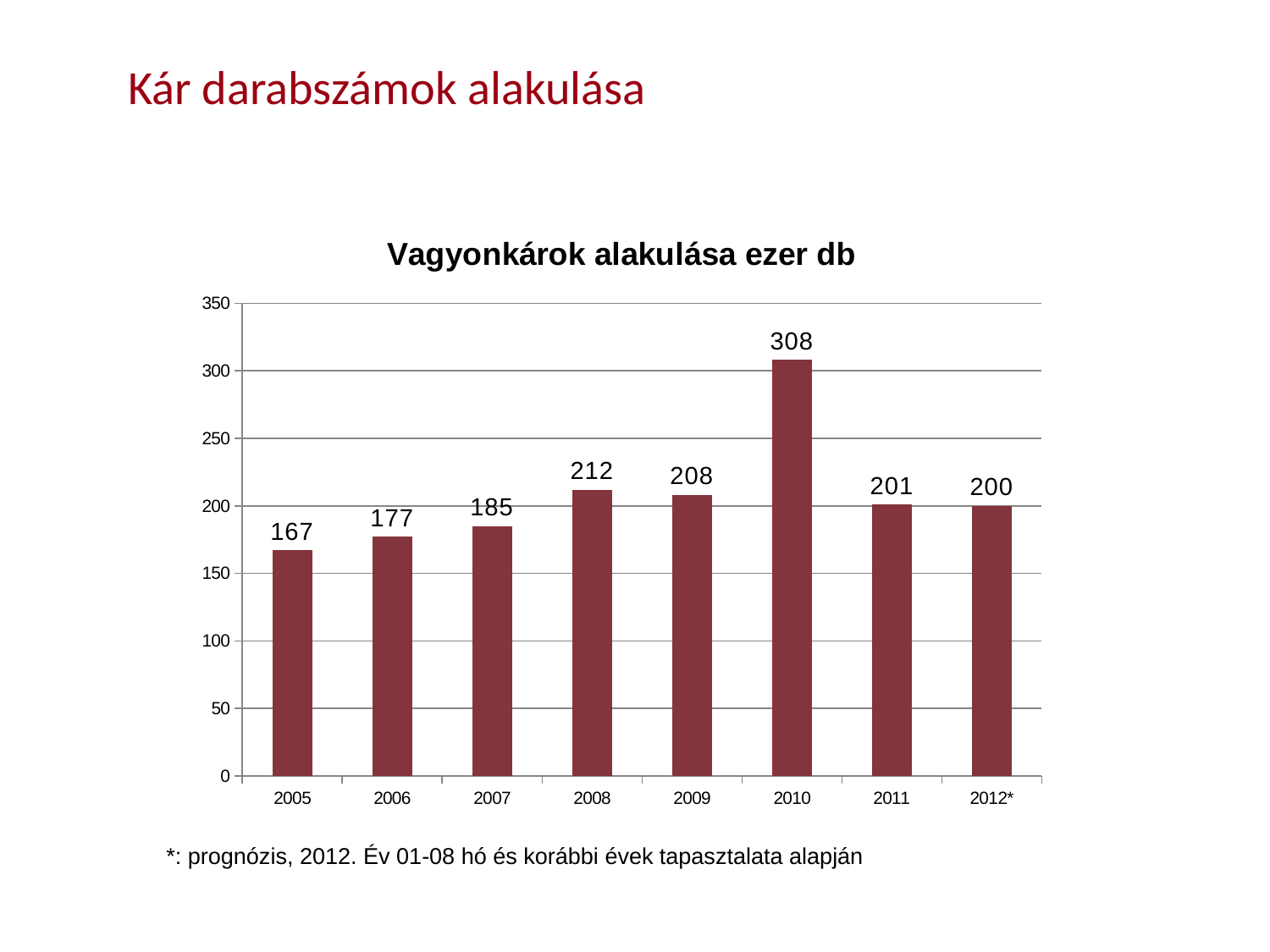
What is the value for 2005? 167 Which is larger, the value for 2008 or the value for 2011? 2008 Which year has the highest value? 2010 What is the difference between the values for 2010 and 2009? 100 How many years are shown on the x axis? 8 What is the difference between the values for 2008 and 2007? 27 What is the value for 2012*? 200 Is the value for 2006 greater or less than 200? less What is the value for 2010? 308 Which year has the lowest value? 2005 What kind of chart is this? bar chart What is the title of the chart? Vagyonkárok alakulása ezer db